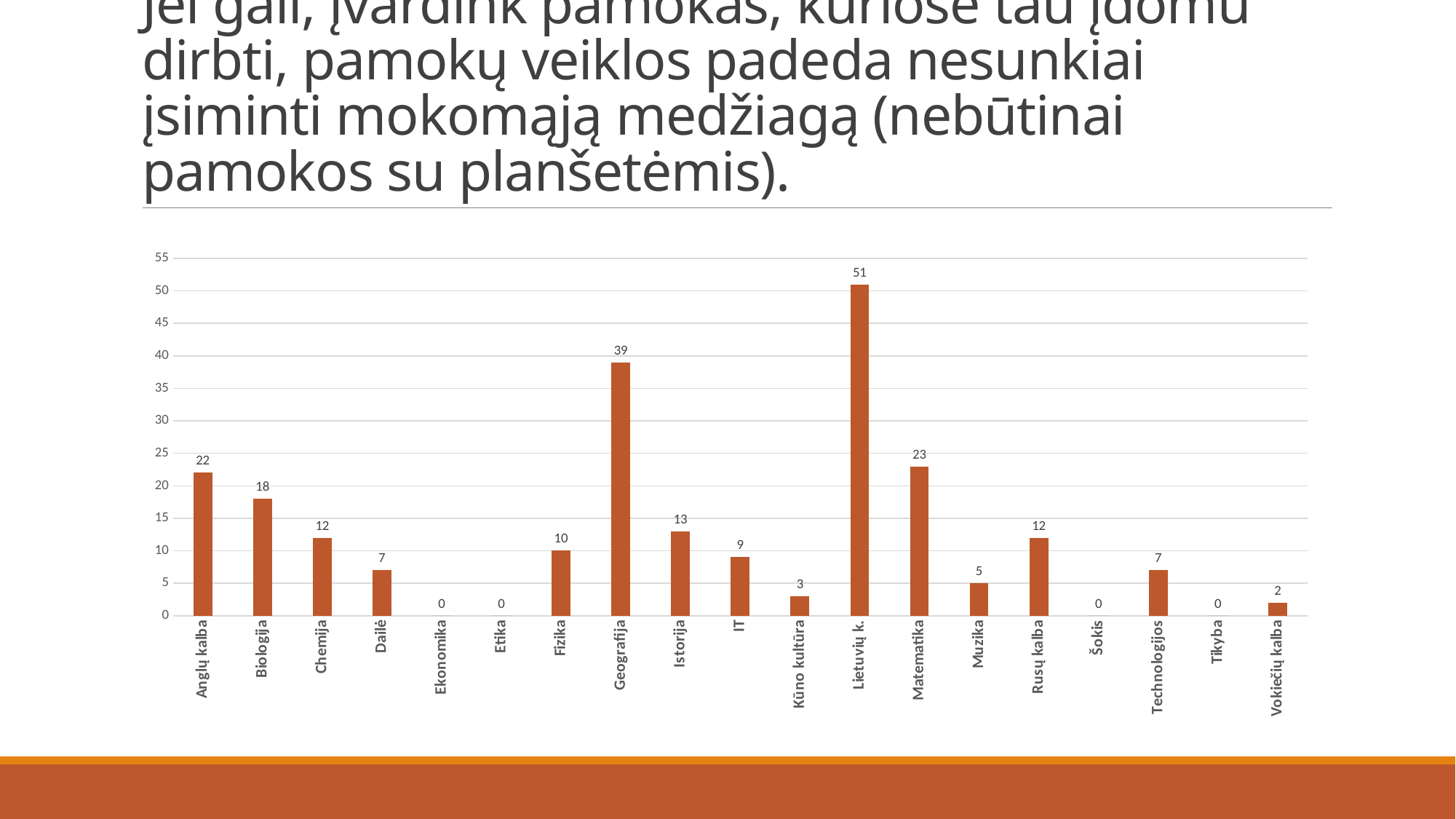
What value is shown for Kūno kultūra? 3 What value is shown for Matematika? 23 What is the highest value shown on the y axis? 55 Which category has the highest value? Lietuvių k. How many categories are shown on the x axis? 19 Which is larger, the value for Matematika or the value for Anglų kalba? Matematika How many categories have a value of 0? 4 What kind of chart is shown on the slide? Bar chart Which is larger, the value for Istorija or the value for IT? Istorija What value is shown for Geografija? 39 What is the difference between the values for Anglų kalba and Biologija? 4 What is the difference between the values for Lietuvių k. and Geografija? 12